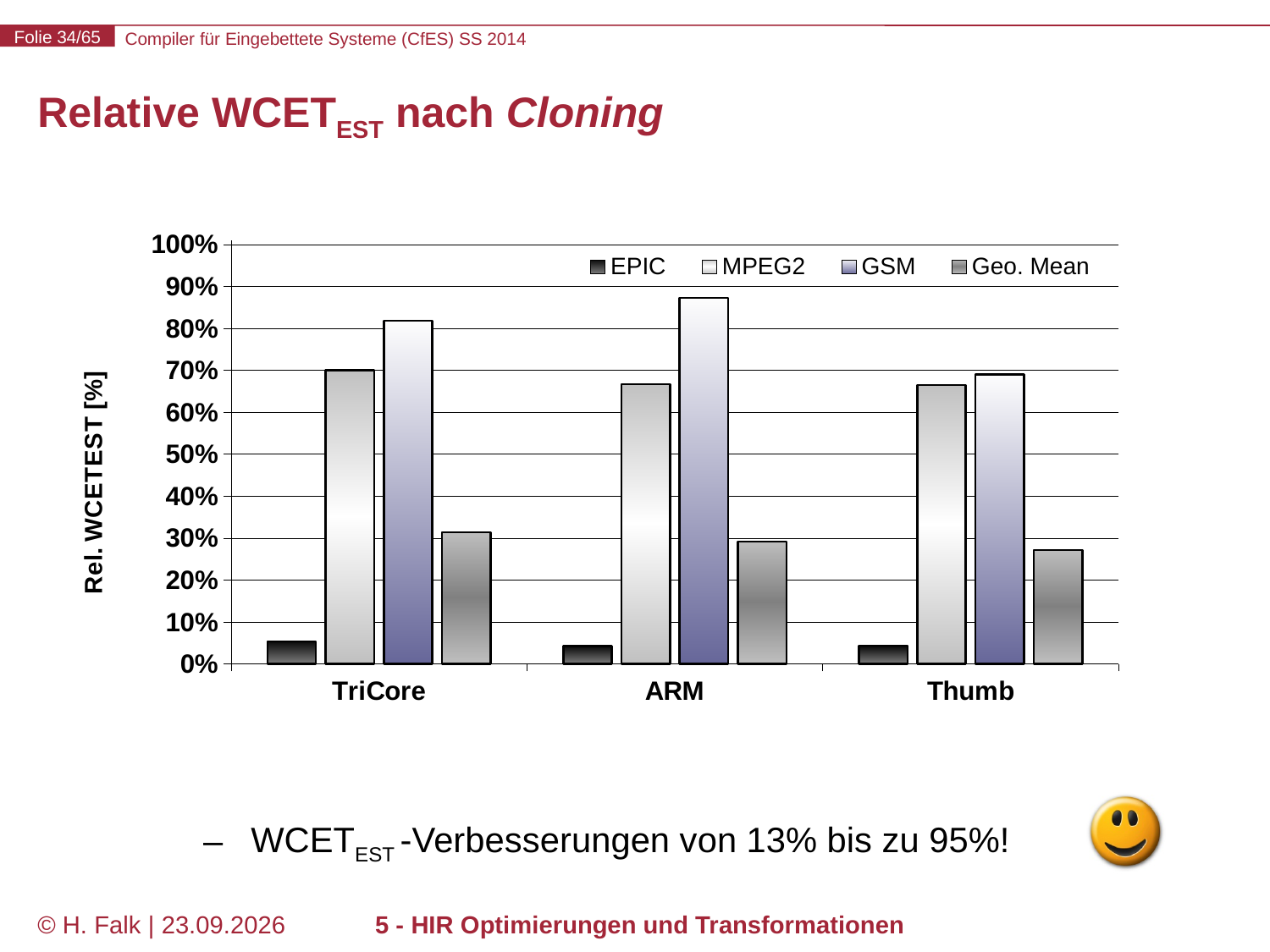
Which series are listed in the legend? EPIC, MPEG2, GSM, Geo. Mean Is the Geo. Mean value for TriCore greater or less than 40%? less Which is larger: the GSM value for TriCore or the GSM value for Thumb? TriCore What kind of chart is shown on the slide? bar chart Which platform has the highest GSM value? ARM Which series has the highest value for ARM? GSM Is the EPIC value for Thumb greater or less than 10%? less What is the label of the y axis? Rel. WCETEST [%] Is the GSM value for ARM greater or less than 80%? greater Which series has the lowest value for TriCore? EPIC How many series does the legend list? 4 How many platform categories are shown on the x axis? 3